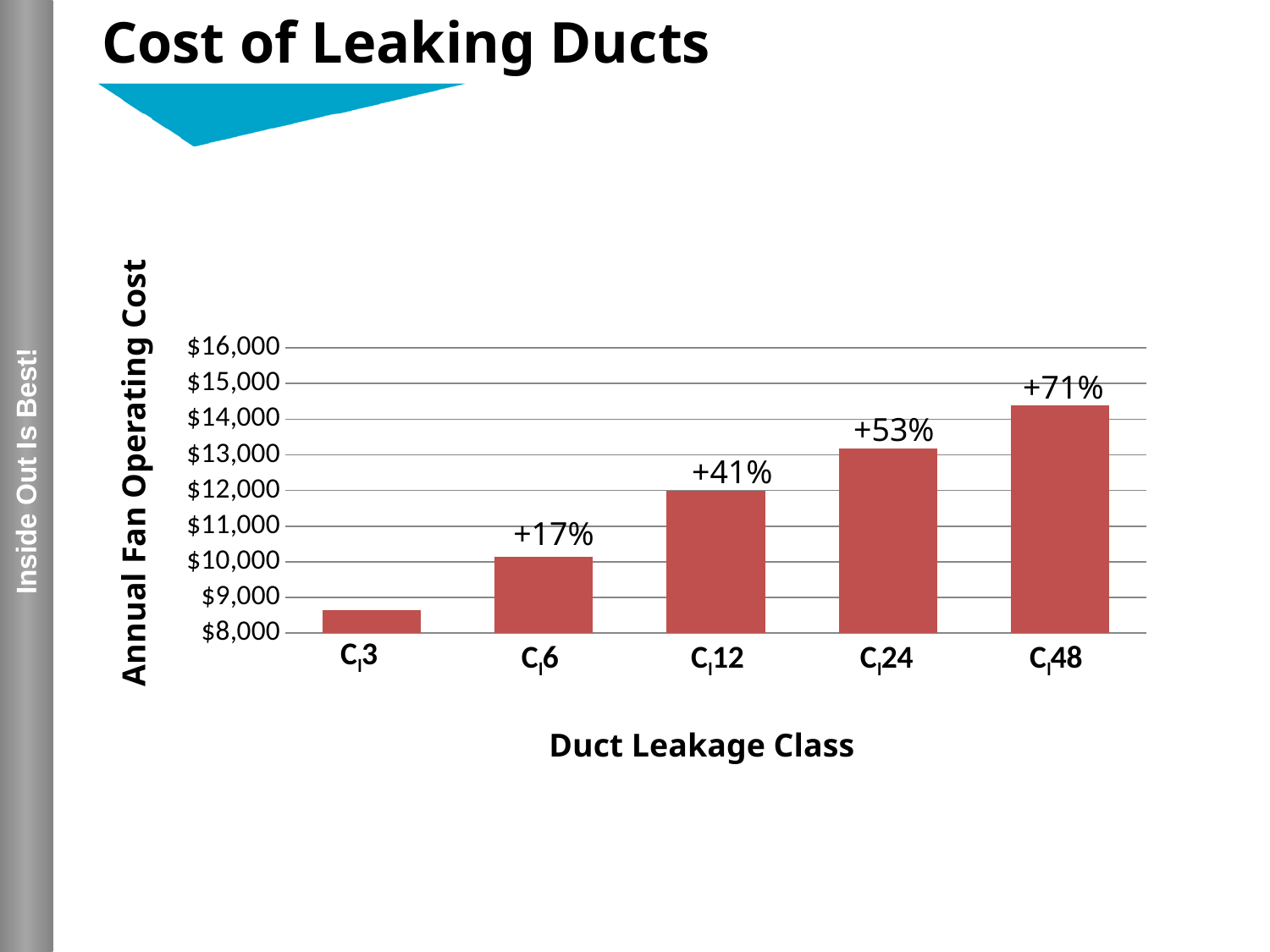
What percentage label is shown above the Cl48 bar? +71% How many duct leakage classes are plotted on the x axis? 5 What kind of chart is shown on the slide? bar chart Which duct leakage class has the lowest annual fan operating cost? Cl3 What is the title of the x axis? Duct Leakage Class Is the annual fan operating cost for Cl3 greater or less than $9,000? less Which duct leakage class has the highest annual fan operating cost? Cl48 What percentage label is shown above the Cl24 bar? +53% What percentage label is shown above the Cl12 bar? +41% Is the annual fan operating cost for Cl48 greater or less than $14,000? greater Do the annual fan operating costs rise or fall as the duct leakage class increases along the x axis? rise What percentage label is shown above the Cl6 bar? +17%